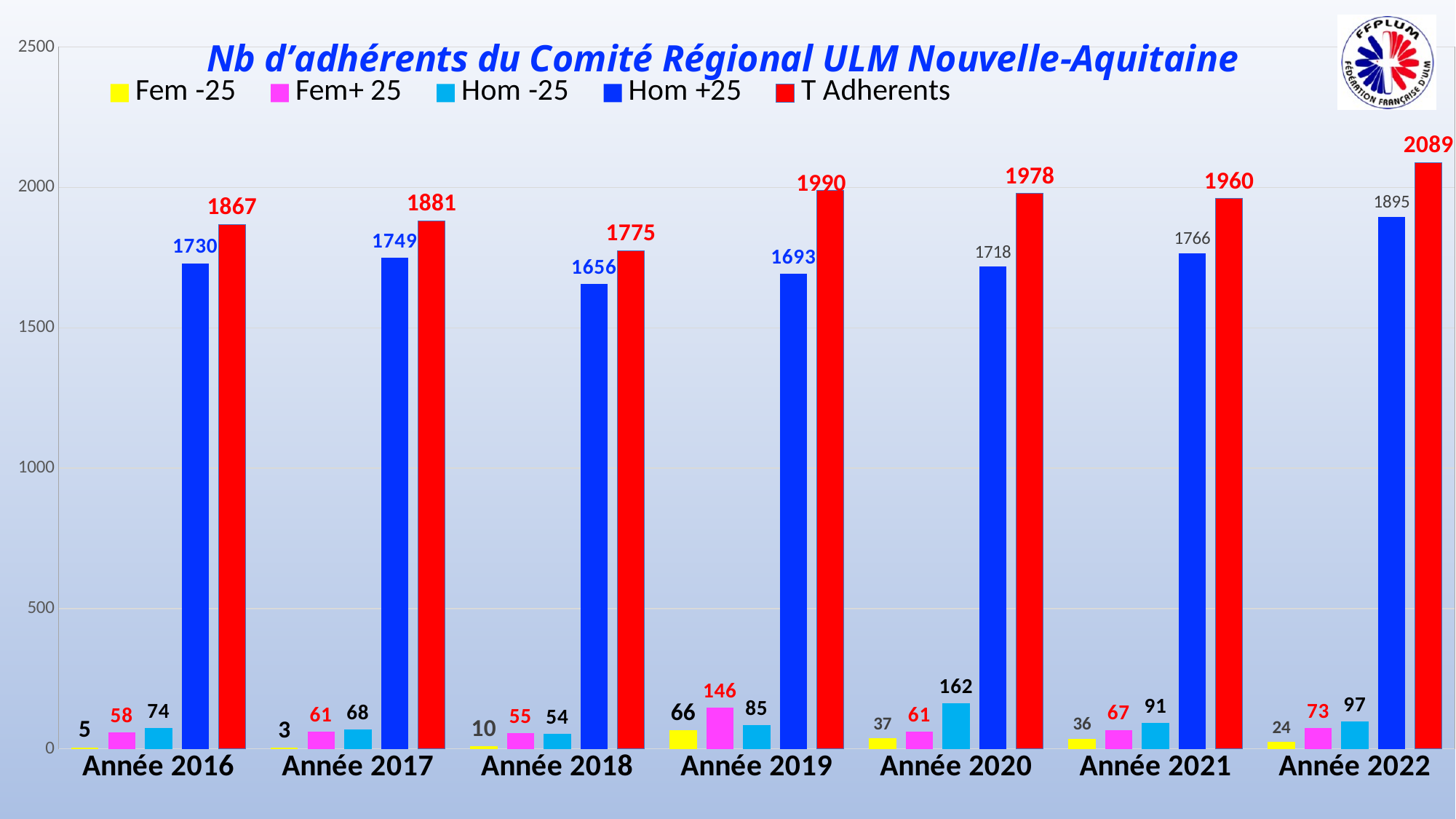
How many years are shown on the x axis? 7 In which year is T Adherents the lowest? Année 2018 What is the value of Fem+ 25 for Année 2019? 146 How many series does the legend list? 5 In which year is T Adherents the highest? Année 2022 What is the title of the chart? Nb d'adhérents du Comité Régional ULM Nouvelle-Aquitaine What is the value of T Adherents for Année 2019? 1990 What kind of chart is shown on the slide? Bar chart What is the value of Hom +25 for Année 2022? 1895 What is the difference between T Adherents in Année 2022 and Année 2021? 129 In which year is Fem -25 the highest? Année 2019 Which year has the larger Hom -25 value, Année 2019 or Année 2020? Année 2020